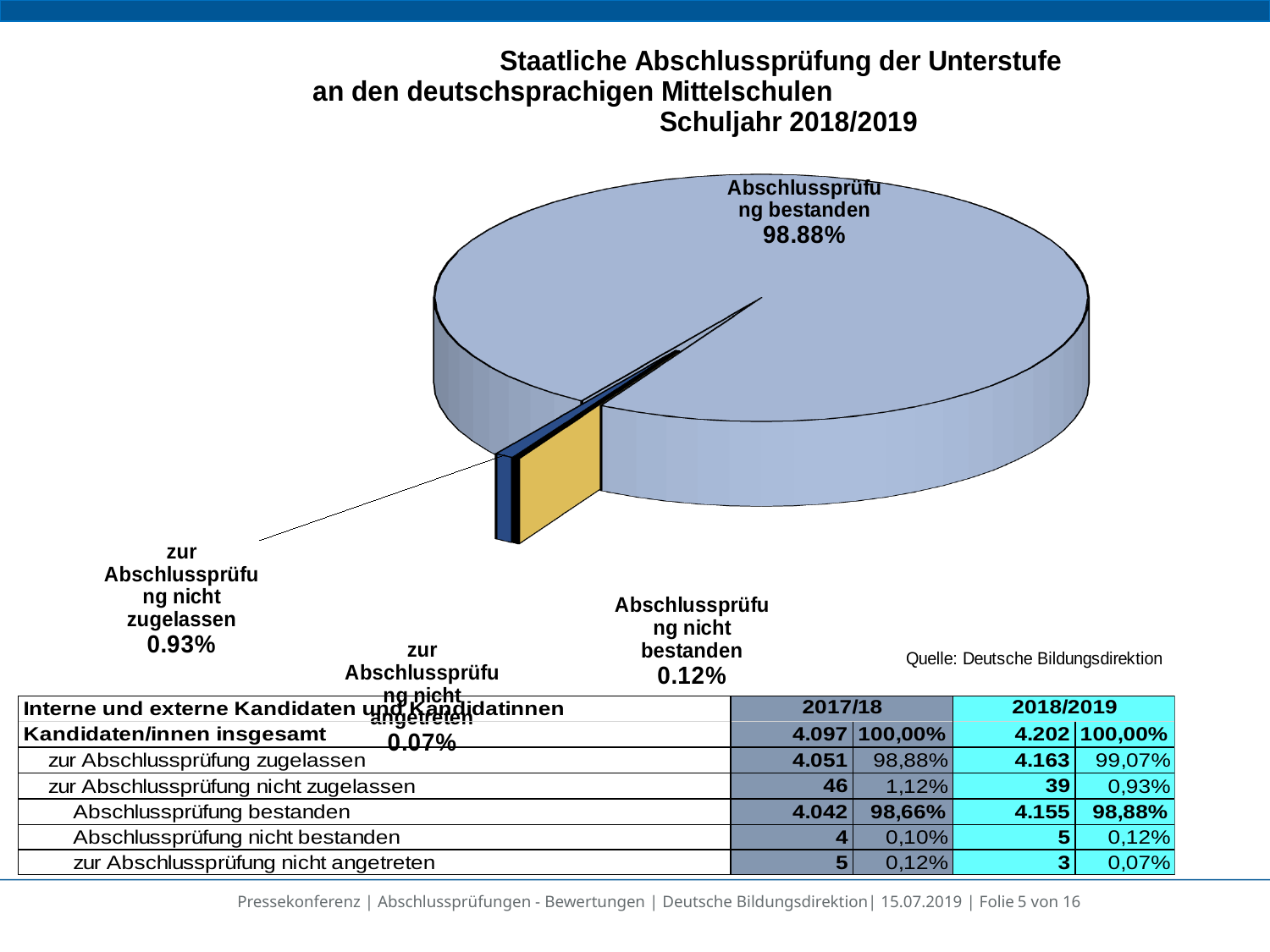
Which slice of the pie is the largest? Abschlussprüfung bestanden What is the value shown for "zur Abschlussprüfung nicht angetreten"? 0.07% What is the value shown for "Abschlussprüfung nicht bestanden"? 0.12% What share of the pie does "Abschlussprüfung bestanden" have? 98.88% What is the difference between the values for "Abschlussprüfung nicht bestanden" and "zur Abschlussprüfung nicht angetreten"? 0.05% Which school year does the chart title refer to? Schuljahr 2018/2019 What is the value shown for "zur Abschlussprüfung nicht zugelassen"? 0.93% What is the difference between the values for "zur Abschlussprüfung nicht zugelassen" and "Abschlussprüfung nicht bestanden"? 0.81% What kind of chart is shown on the slide? pie chart Which is larger, the value for "Abschlussprüfung nicht bestanden" or the value for "zur Abschlussprüfung nicht angetreten"? Abschlussprüfung nicht bestanden Which slice of the pie is the smallest? zur Abschlussprüfung nicht angetreten How many slices does the pie chart have? 4